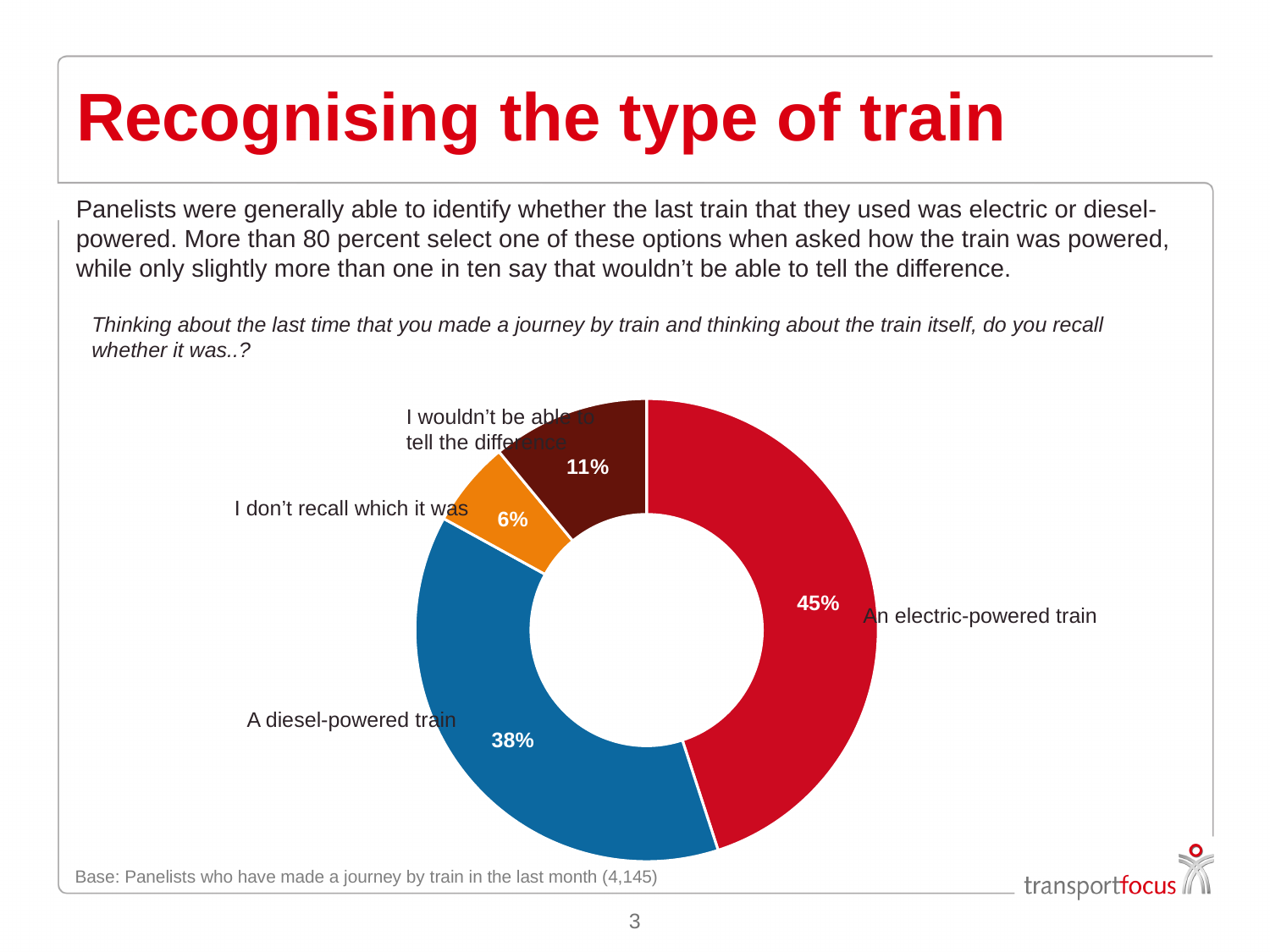
What percentage of panelists said they wouldn't be able to tell the difference? 11% How many response categories are shown in the chart? 4 What percentage of panelists said their last train was an electric-powered train? 45% What percentage of panelists said their last train was a diesel-powered train? 38% Which response has the largest share of the chart? An electric-powered train What colour is the segment for 'A diesel-powered train'? Blue What percentage of panelists said they don't recall which it was? 6% What kind of chart is shown on the slide? Doughnut (pie) chart Which response has the smallest share of the chart? I don't recall which it was What is the difference in percentage points between the electric-powered train and diesel-powered train responses? 7 percentage points Which is larger: the share for 'I wouldn't be able to tell the difference' or 'I don't recall which it was'? I wouldn't be able to tell the difference What is the base (number of panelists) stated for the chart? 4,145